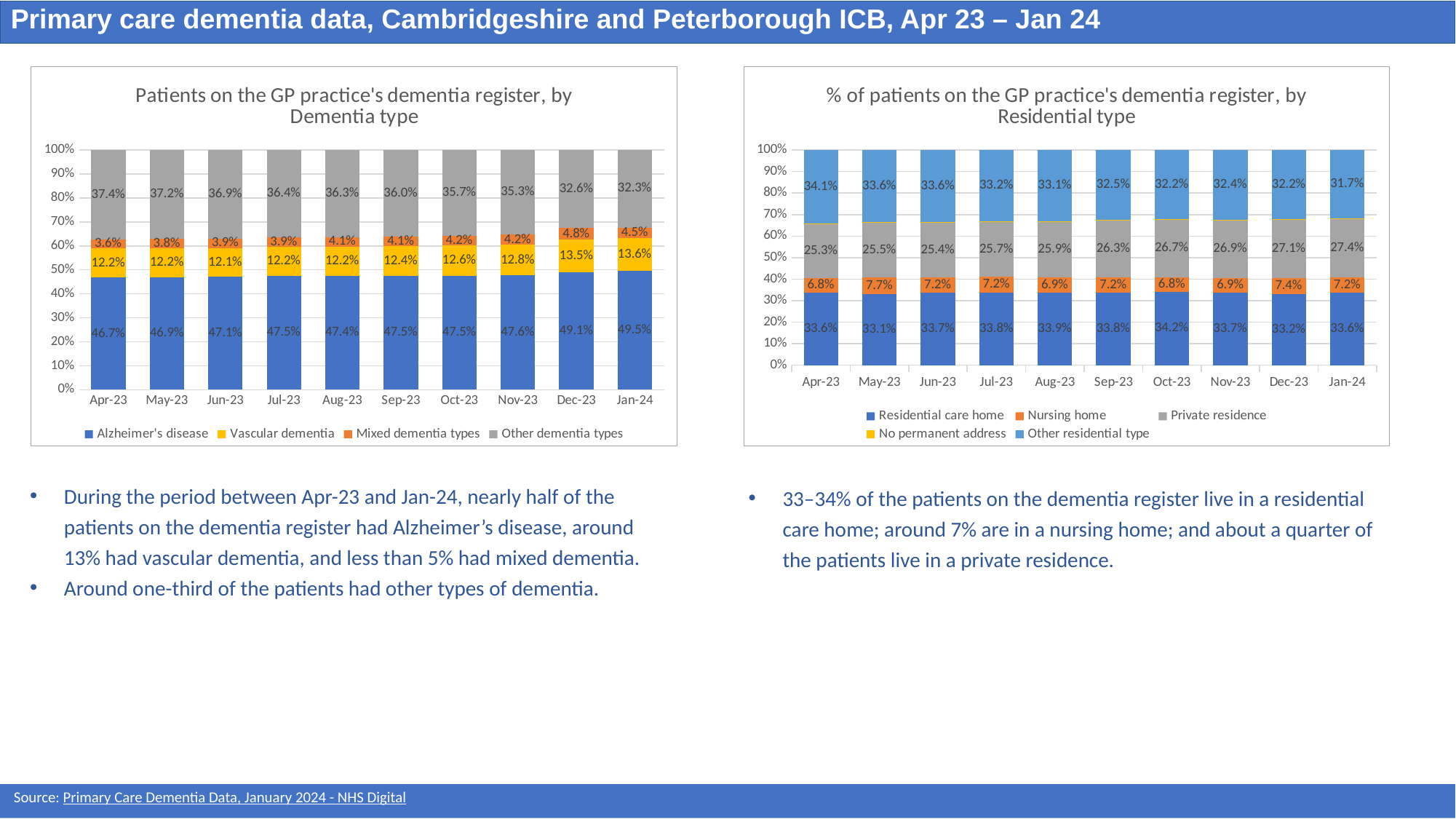
In the chart 'Patients on the GP practice's dementia register, by Dementia type', what is the difference between the Alzheimer's disease share in Jan-24 and in Apr-23? 2.8 percentage points What type of chart is the chart '% of patients on the GP practice's dementia register, by Residential type'? Stacked bar chart In the chart '% of patients on the GP practice's dementia register, by Residential type', what percentage of patients lived in a private residence in Jan-24? 27.4% In the chart 'Patients on the GP practice's dementia register, by Dementia type', does the Other dementia types share rise or fall from Apr-23 to Jan-24? Fall In the chart 'Patients on the GP practice's dementia register, by Dementia type', what percentage of patients had Alzheimer's disease in Jan-24? 49.5% In the chart '% of patients on the GP practice's dementia register, by Residential type', what is the Nursing home value for May-23? 7.7% How many months are shown on the x axis of the chart '% of patients on the GP practice's dementia register, by Residential type'? 10 In the chart '% of patients on the GP practice's dementia register, by Residential type', which is larger in Apr-23: Residential care home or Other residential type? Other residential type In the chart 'Patients on the GP practice's dementia register, by Dementia type', in which month is the Mixed dementia types share highest? Dec-23 How many series does the legend list in the chart 'Patients on the GP practice's dementia register, by Dementia type'? 4 In the chart 'Patients on the GP practice's dementia register, by Dementia type', what is the value for Other dementia types in Apr-23? 37.4% In the chart '% of patients on the GP practice's dementia register, by Residential type', in which month is the Residential care home share highest? Oct-23